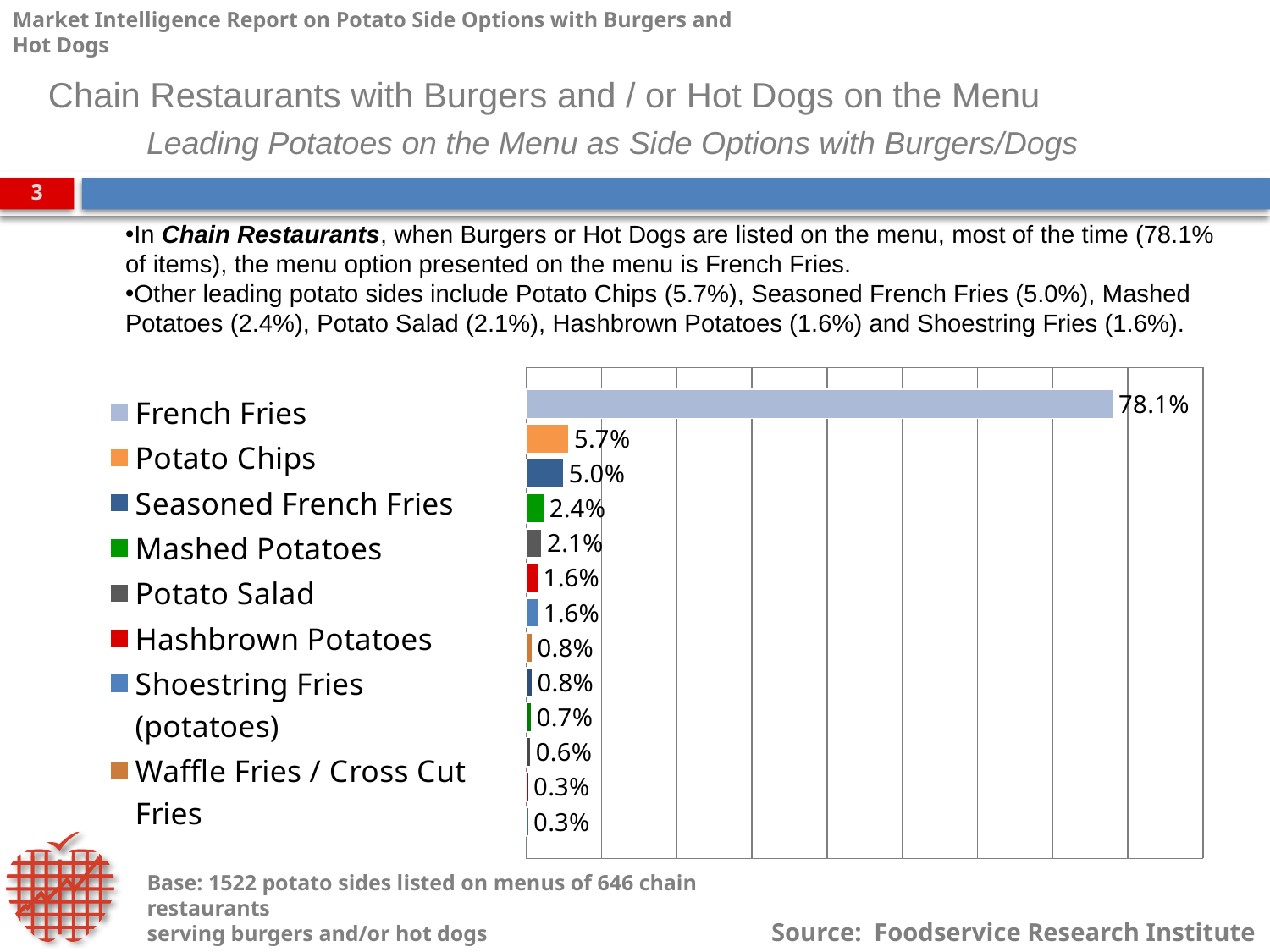
How many entries does the chart's legend list? 8 What is the difference between the values for Potato Chips and Seasoned French Fries? 0.7% What is the value for Waffle Fries / Cross Cut Fries? 0.8% What percentage is shown for Seasoned French Fries? 5.0% What is the difference between the values for French Fries and Potato Chips? 72.4% Which potato side has the highest value in the chart? French Fries What percentage is shown for French Fries? 78.1% What kind of chart is shown on the slide? Bar chart What is the value for Potato Chips? 5.7% What percentage is shown for Potato Salad? 2.1% What is the value for Mashed Potatoes? 2.4% Which is larger, the value for Mashed Potatoes or the value for Potato Salad? Mashed Potatoes